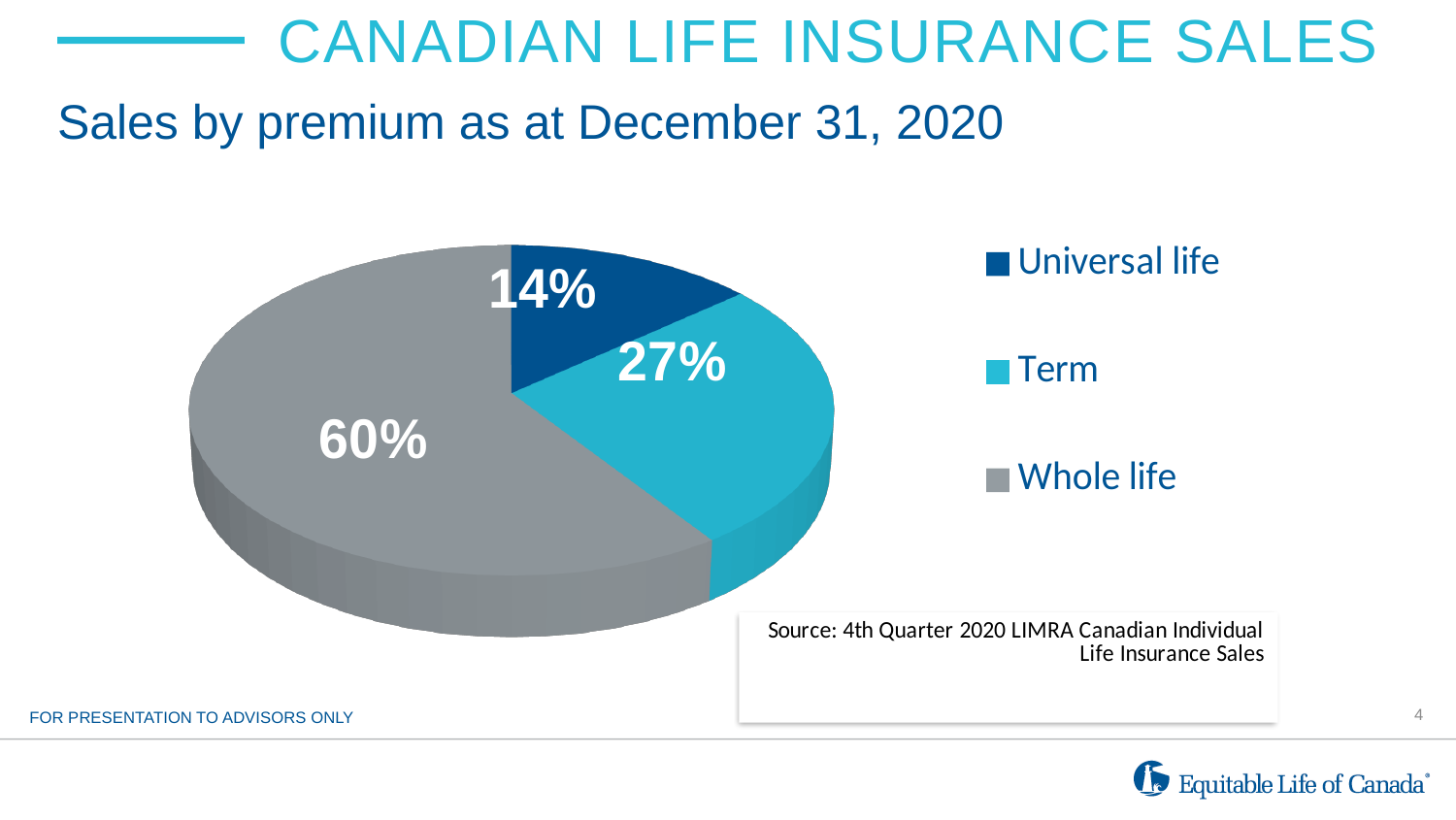
Which colour represents Whole life in the pie chart? Grey Which product type has the smallest share of sales by premium? Universal life What kind of chart is shown on the slide? Pie chart Which has a larger share of sales by premium, Term or Universal life? Term Which product type has the largest share of sales by premium? Whole life What share of sales by premium does Term account for? 27% What share of sales by premium does Universal life account for? 14% What is the difference in percentage points between the Whole life share and the Term share? 33 How many slices does the pie chart have? 3 What is the difference in percentage points between the Term share and the Universal life share? 13 How many entries does the legend list? 3 What share of sales by premium does Whole life account for? 60%